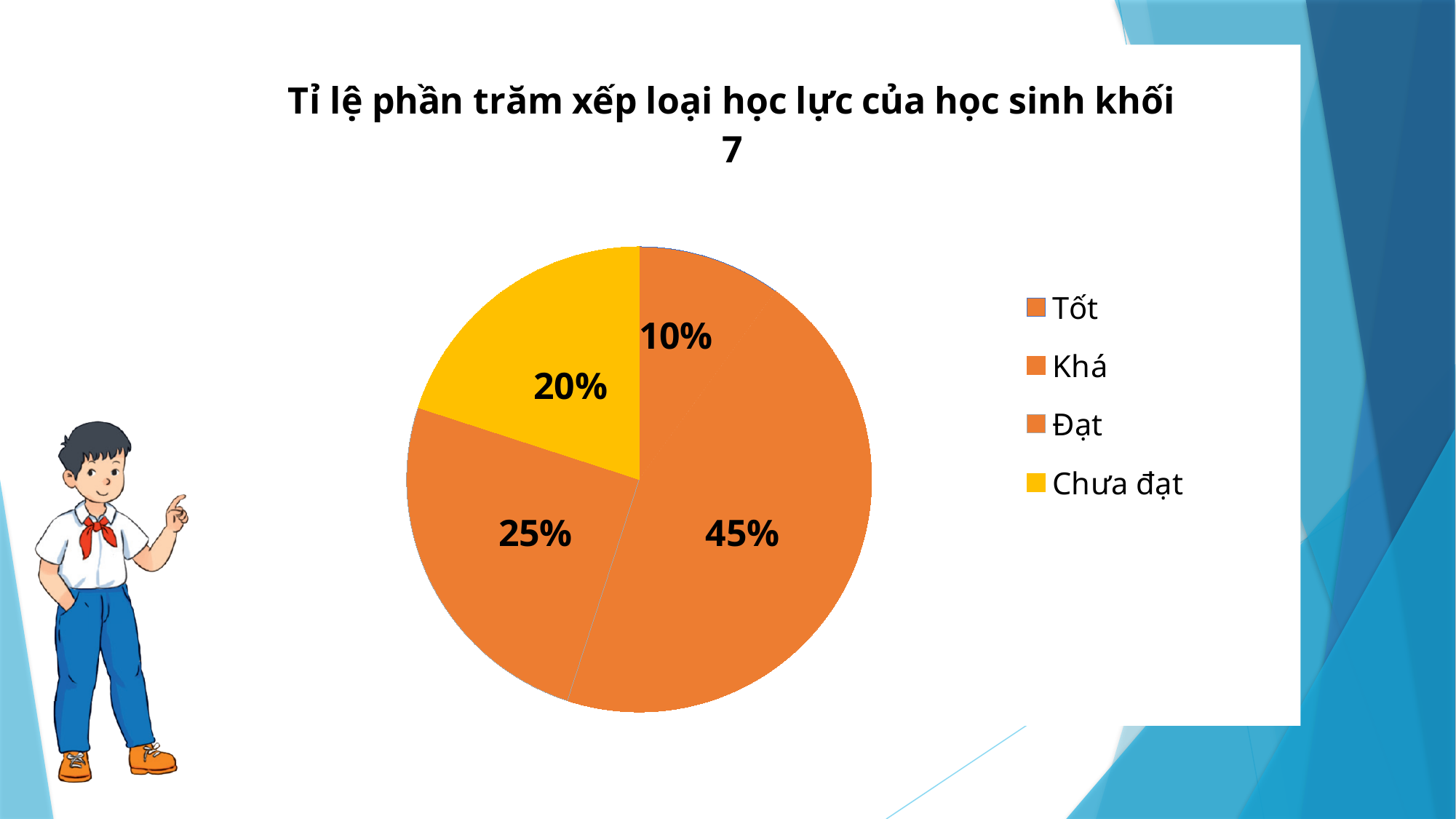
What percentage of the pie is labelled for Chưa đạt? 20% Which is larger, the share for Đạt or the share for Chưa đạt? Đạt What is the title of the chart? Tỉ lệ phần trăm xếp loại học lực của học sinh khối 7 What is the difference in percentage points between Khá and Đạt? 20 How many categories does the legend list? 4 What percentage of the pie is labelled for Khá? 45% Which category has the smallest share of the pie? Tốt What percentage of the pie is labelled for Tốt? 10% What percentage of the pie is labelled for Đạt? 25% Which colour is used for the Chưa đạt slice? yellow Which category has the largest share of the pie? Khá What kind of chart is shown on the slide? pie chart